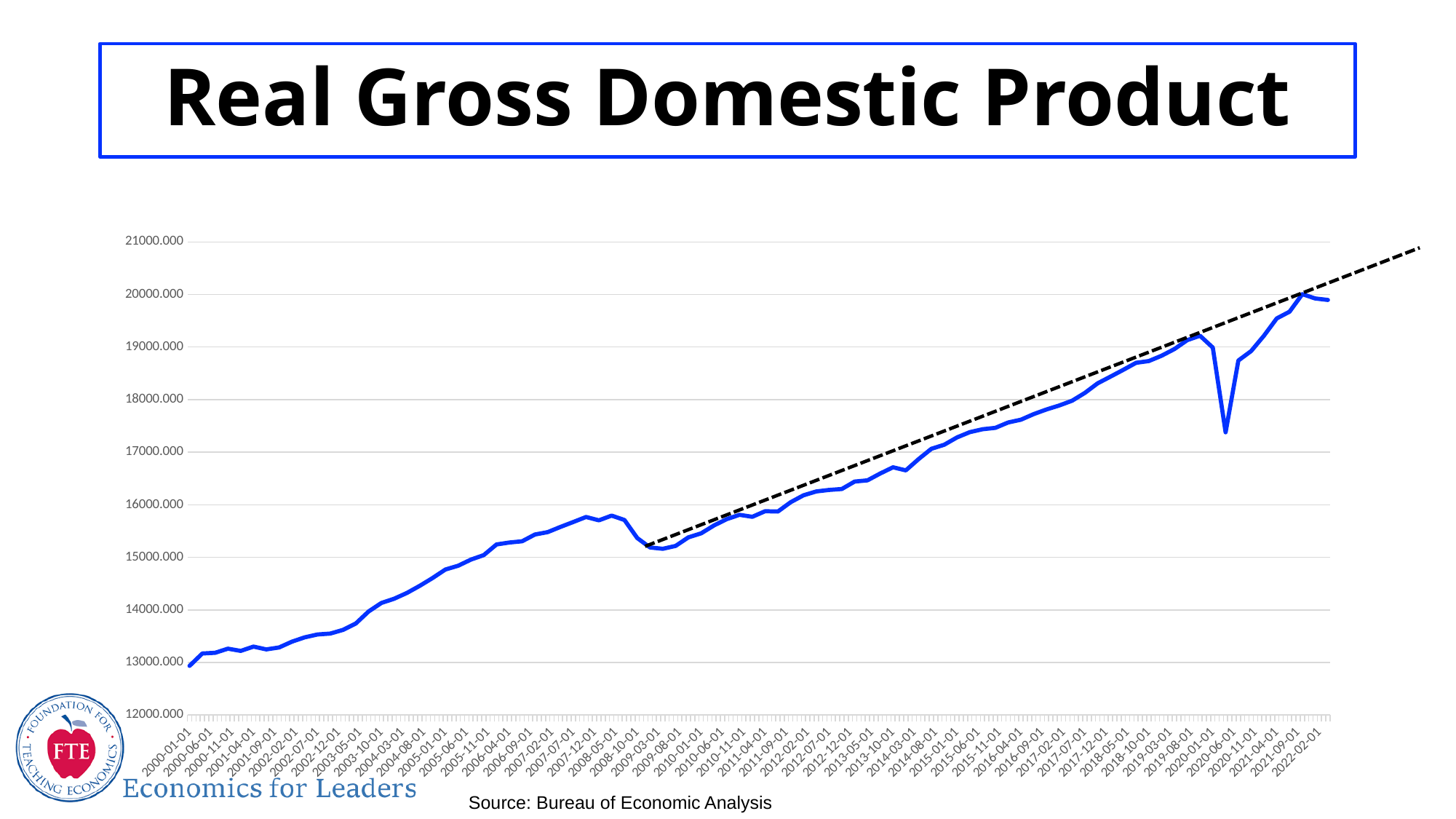
Is the value for 2020-06-01 greater or less than 17000.000? greater Is the value for 2015-01-01 greater or less than 17000.000? greater What kind of chart is shown on the slide? line chart Overall, do the values rise or fall from 2000 to 2022 along the x axis? rise Which date has the lowest value on the chart? 2000-01-01 Is the value for 2010-01-01 greater or less than 16000.000? less Which is larger, the value for 2019-08-01 or the value for 2020-06-01? 2019-08-01 What is the title of the chart? Real Gross Domestic Product What source is cited for the chart's data? Bureau of Economic Analysis